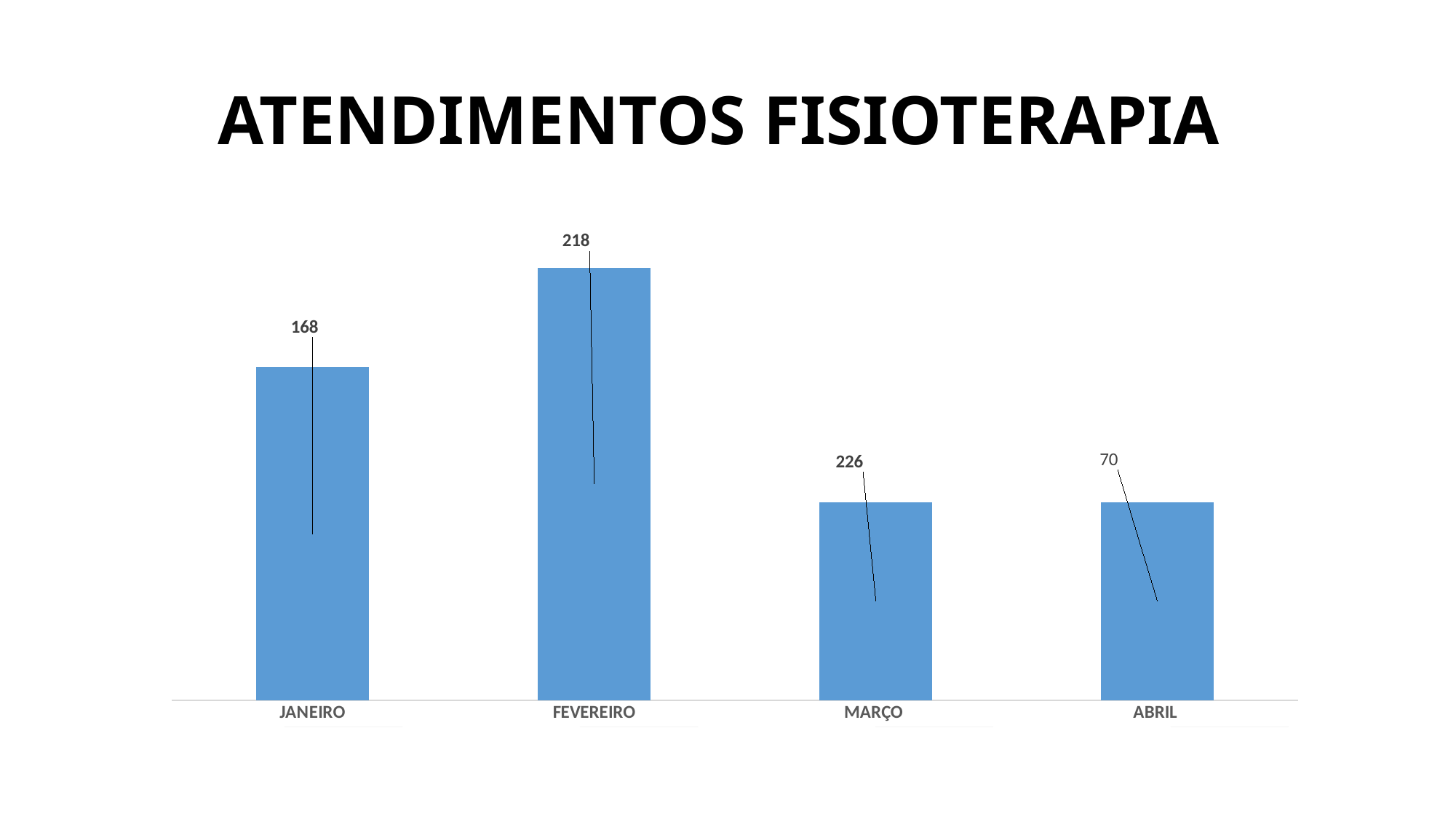
What is the value for ABRIL? 70 What kind of chart is shown on the slide? Bar chart How many categories are shown on the x axis? 4 What is the value for FEVEREIRO? 218 What is the difference between the values for FEVEREIRO and ABRIL? 148 What is the title of the chart? ATENDIMENTOS FISIOTERAPIA What colour are the bars in the chart? Blue What is the difference between the values for FEVEREIRO and JANEIRO? 50 Which is larger, the value for JANEIRO or the value for FEVEREIRO? FEVEREIRO Which is larger, the value for JANEIRO or the value for ABRIL? JANEIRO What is the value for JANEIRO? 168 What is the value for MARÇO? 226